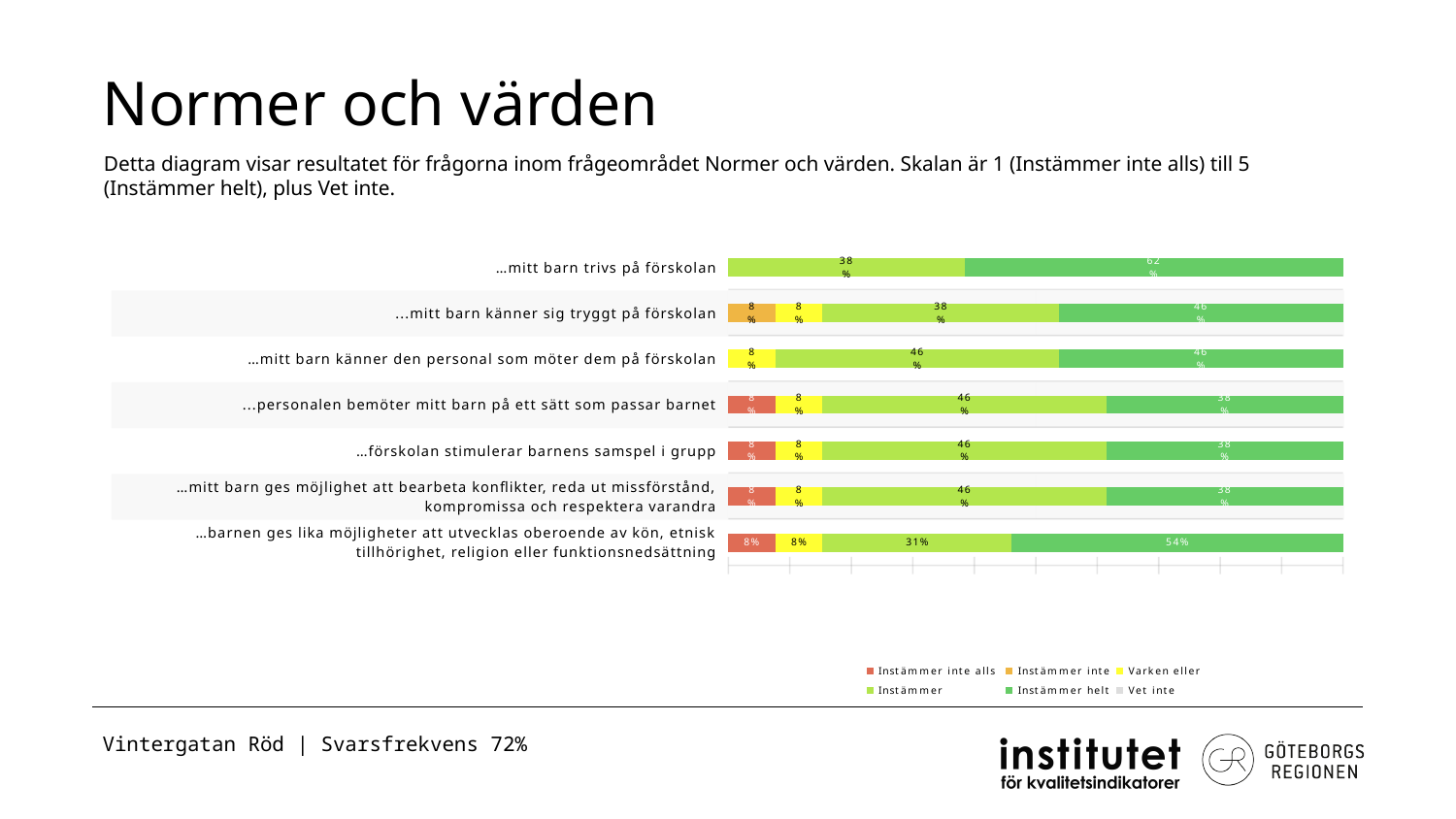
What is the 'Instämmer helt' value for '…barnen ges lika möjligheter att utvecklas oberoende av kön, etnisk tillhörighet, religion eller funktionsnedsättning'? 54% What is the 'Instämmer' value for '…förskolan stimulerar barnens samspel i grupp'? 46% For '…mitt barn trivs på förskolan', what is the difference between the 'Instämmer helt' and 'Instämmer' values? 24 percentage points What kind of chart is shown on the slide? Stacked bar chart How many statements (categories) are plotted in the chart? 7 What is the 'Instämmer' value for '…mitt barn trivs på förskolan'? 38% What is the title of the slide containing the chart? Normer och värden How many series does the legend list? 6 Which statement has the highest 'Instämmer helt' share? …mitt barn trivs på förskolan Which statement has the lowest 'Instämmer' share? …barnen ges lika möjligheter att utvecklas oberoende av kön, etnisk tillhörighet, religion eller funktionsnedsättning Which has a larger 'Instämmer helt' share: '…mitt barn känner sig tryggt på förskolan' or '…personalen bemöter mitt barn på ett sätt som passar barnet'? …mitt barn känner sig tryggt på förskolan What is the 'Instämmer helt' value for '…mitt barn trivs på förskolan'? 62%